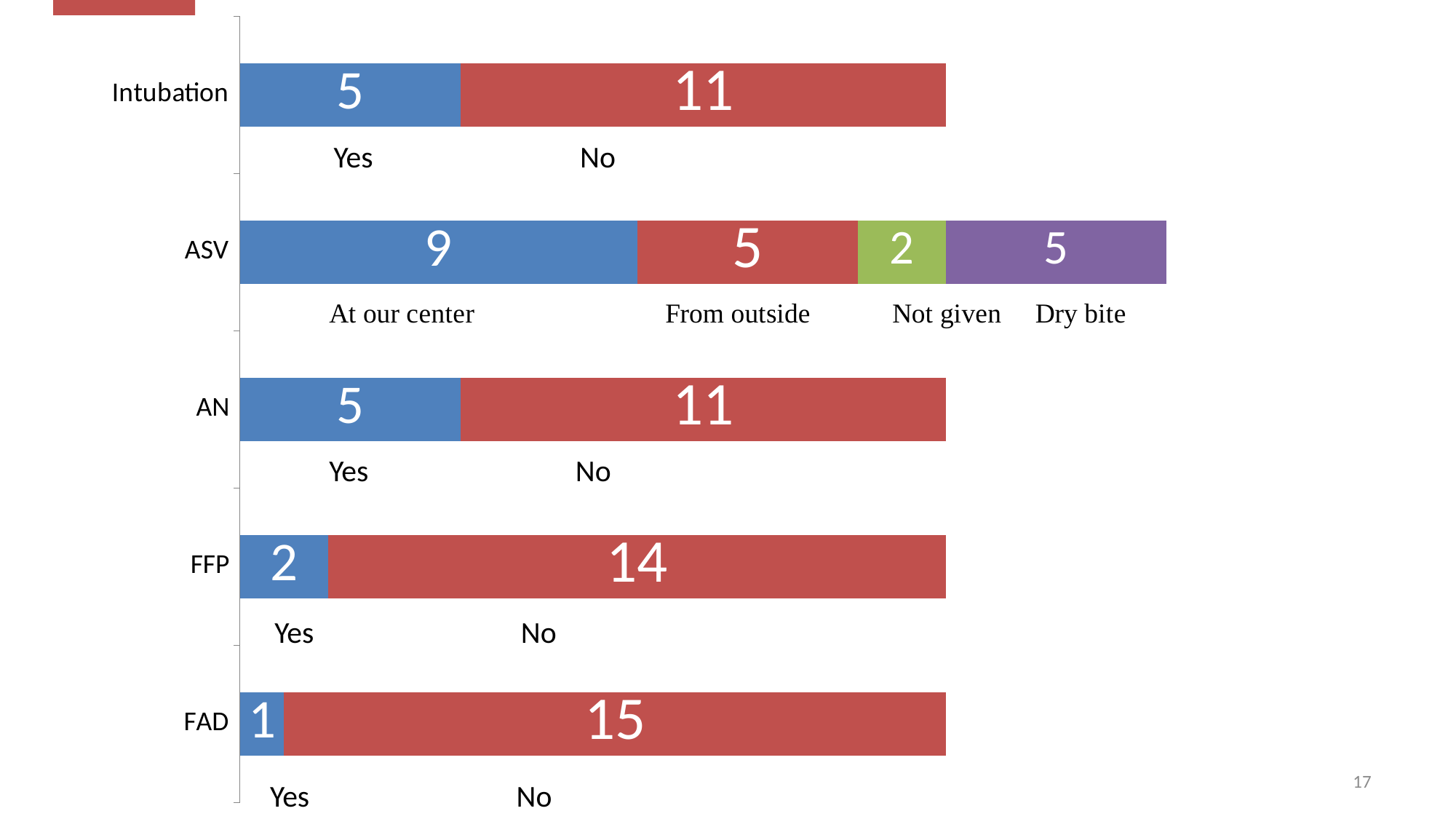
What is the 'At our center' value for ASV? 9 What is the total of the stacked bar for ASV? 21 What is the 'No' value for FFP? 14 How many segments make up the ASV bar? 4 What is the 'Dry bite' value for ASV? 5 Which is larger for AN, the 'Yes' value or the 'No' value? No What is the 'Yes' value for Intubation? 5 What is the 'Yes' value for FAD? 1 What is the difference between the 'No' and 'Yes' values for FAD? 14 Which category has the highest 'No' value? FAD What kind of chart is shown on the slide? stacked bar chart How many categories are plotted on the vertical axis? 5